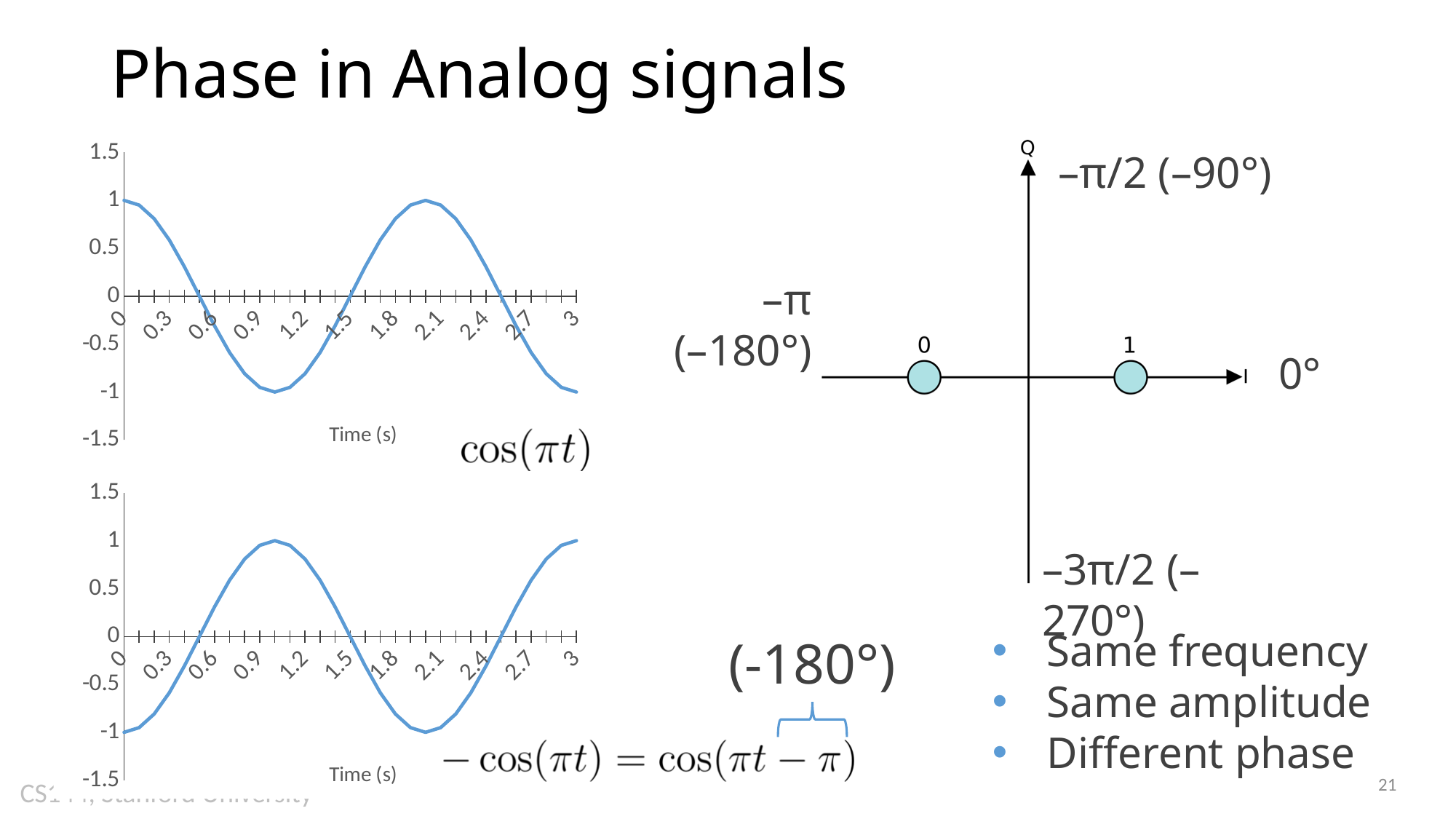
In the top-left chart, is the value at time 1.0 greater or less than 0? less What is the x-axis label of the top-left chart? Time (s) In the bottom-left chart, do the values rise or fall between time 0 and time 0.9? rise In the bottom-left chart, what is the value of the curve at time 0? -1 In the bottom-left chart, is the value at time 1.0 greater or less than 0? greater What kind of chart is the top-left chart on the slide? line chart In the top-left chart, do the values rise or fall between time 0 and time 0.9? fall How many tick labels are shown on the x axis of the top-left chart? 11 In the top-left chart, what is the value of the curve at time 0? 1 In the I/Q diagram on the right, how many plotted points are shown? 2 What is the highest tick value shown on the y axis of the bottom-left chart? 1.5 In the top-left chart, which is larger: the value at time 0 or the value at time 1.0? time 0